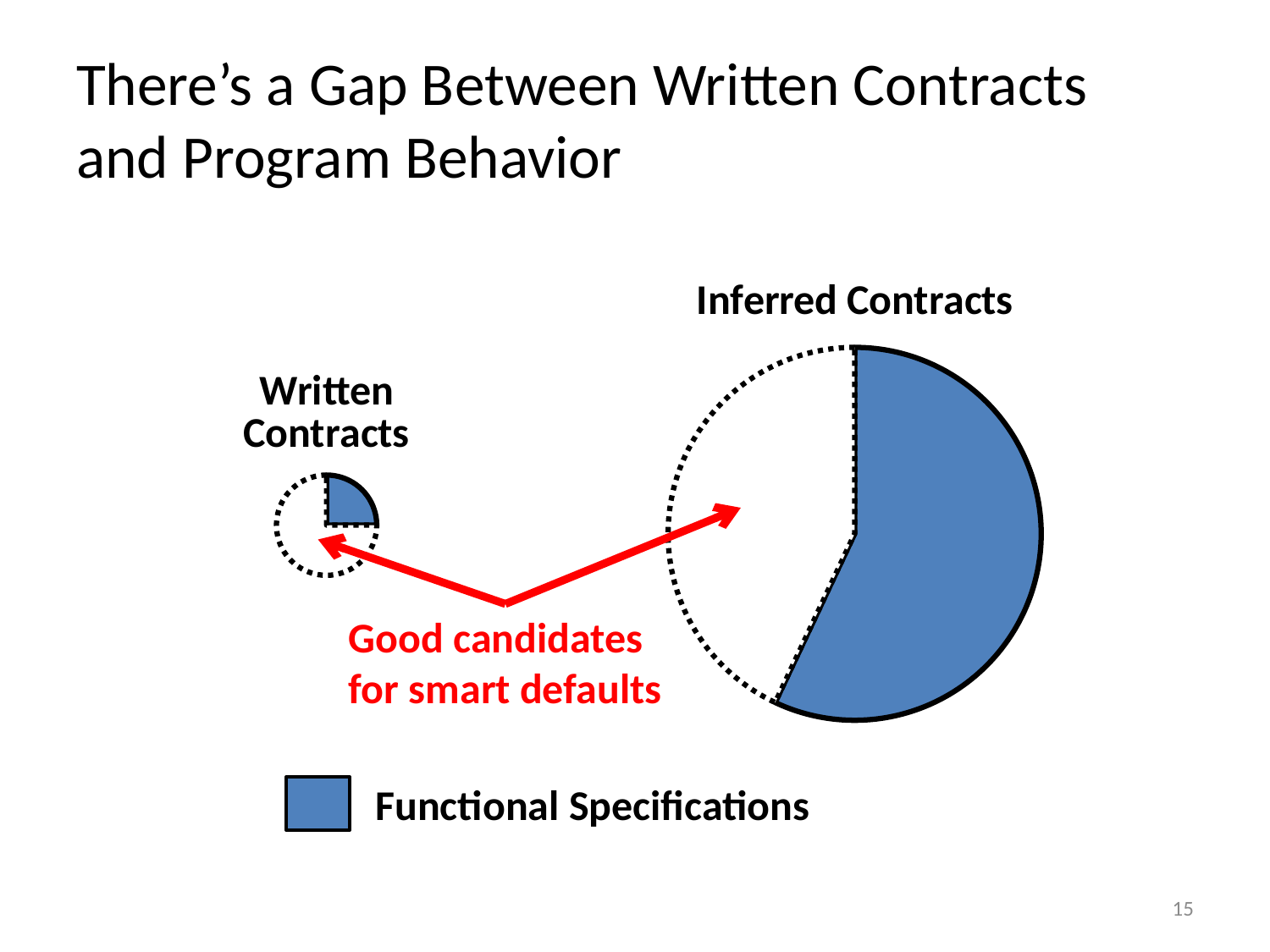
Which pie chart has the larger blue (Functional Specifications) share, "Written Contracts" or "Inferred Contracts"? Inferred Contracts What does the blue colour in the pie charts represent, according to the legend? Functional Specifications In the "Inferred Contracts" pie chart, is the blue Functional Specifications slice greater or less than half of the pie? greater How many entries does the legend list? 1 What is the title of the larger pie chart on the right? Inferred Contracts How many pie charts are shown on the slide? 2 What kind of chart is used for the "Written Contracts" and "Inferred Contracts" figures? Pie chart In the "Written Contracts" pie chart, is the blue Functional Specifications slice greater or less than half of the pie? less